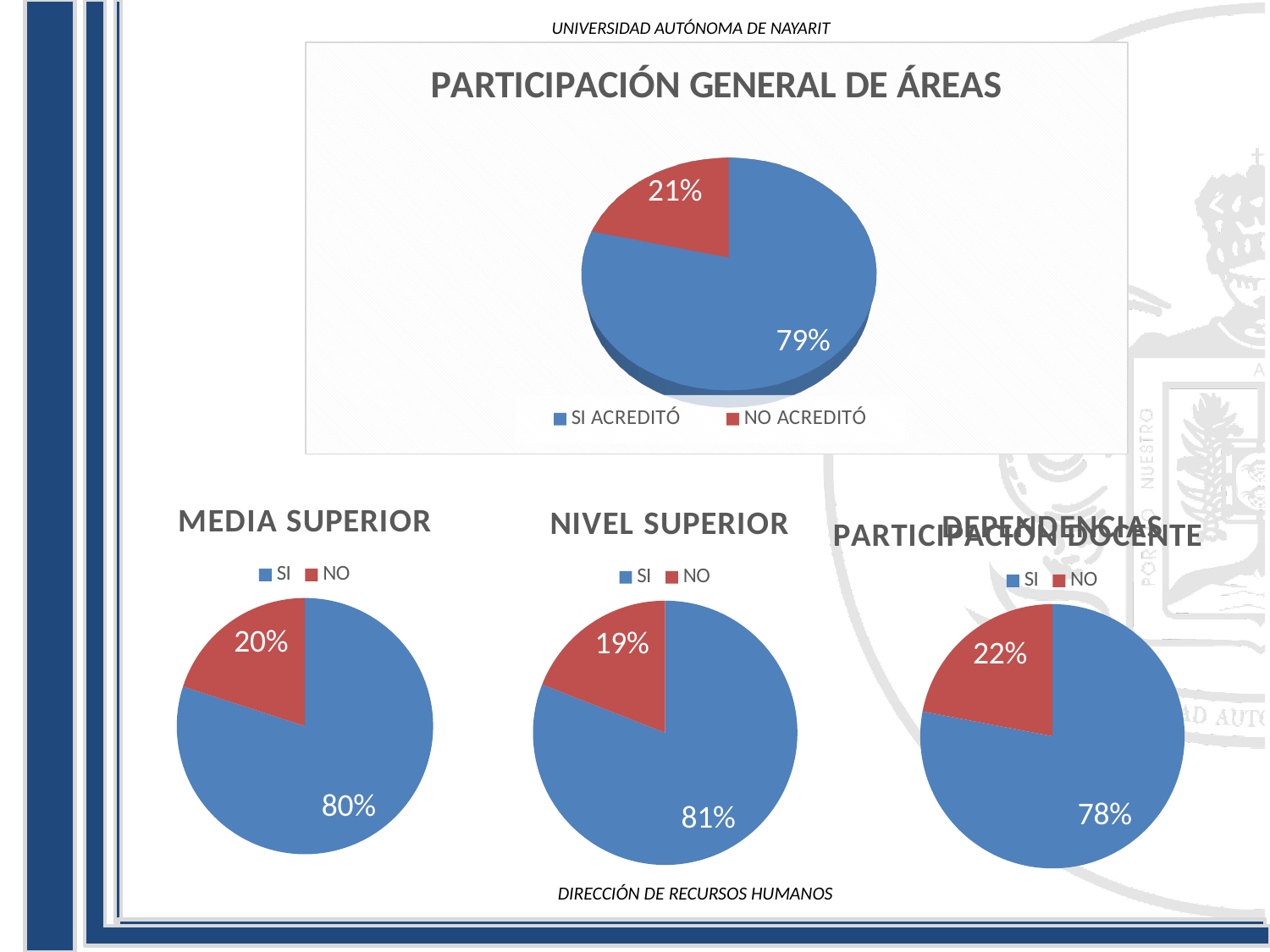
In the NIVEL SUPERIOR chart, what is the difference between the SI and NO shares? 62% In the MEDIA SUPERIOR chart, which slice is larger, SI or NO? SI What kind of chart is the PARTICIPACIÓN GENERAL DE ÁREAS chart? Pie chart In the NIVEL SUPERIOR chart, what share of the pie is SI? 81% In the bottom-right pie chart, what share of the pie is SI? 78% In the bottom-right pie chart, what share of the pie is NO? 22% How many entries does the legend of the PARTICIPACIÓN GENERAL DE ÁREAS chart list? 2